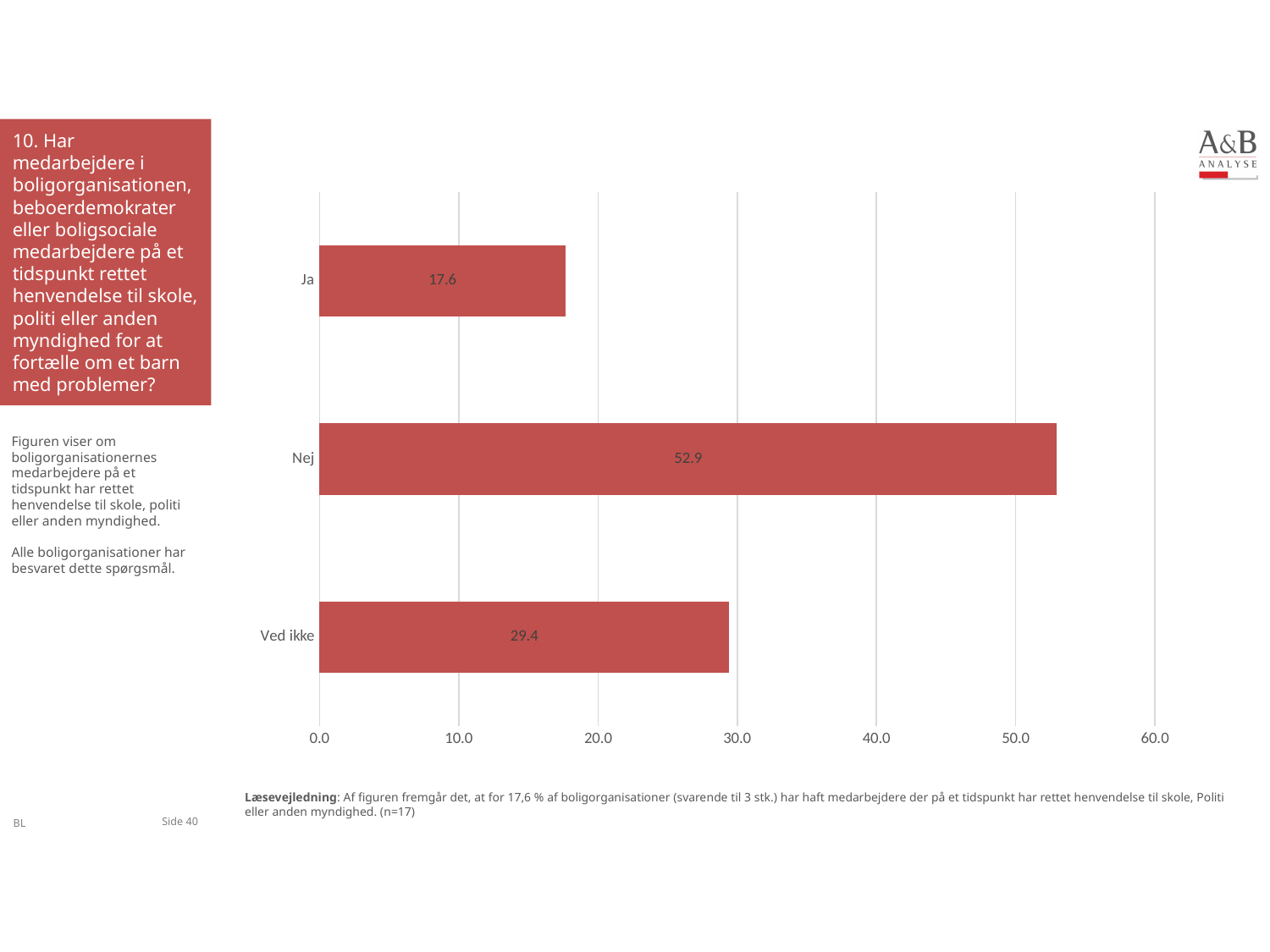
What is the value for "Nej"? 52.9 What is the highest value shown on the x axis? 60.0 What kind of chart is shown on the slide? Bar chart How many categories are shown in the chart? 3 Which category has the highest value? Nej Is the value for "Nej" greater or less than 50.0? greater Which category has the lowest value? Ja What is the difference between the values for "Nej" and "Ja"? 35.3 What is the value for "Ved ikke"? 29.4 What is the value for "Ja"? 17.6 Which is larger, the value for "Ved ikke" or the value for "Ja"? Ved ikke What is the difference between the values for "Ved ikke" and "Ja"? 11.8